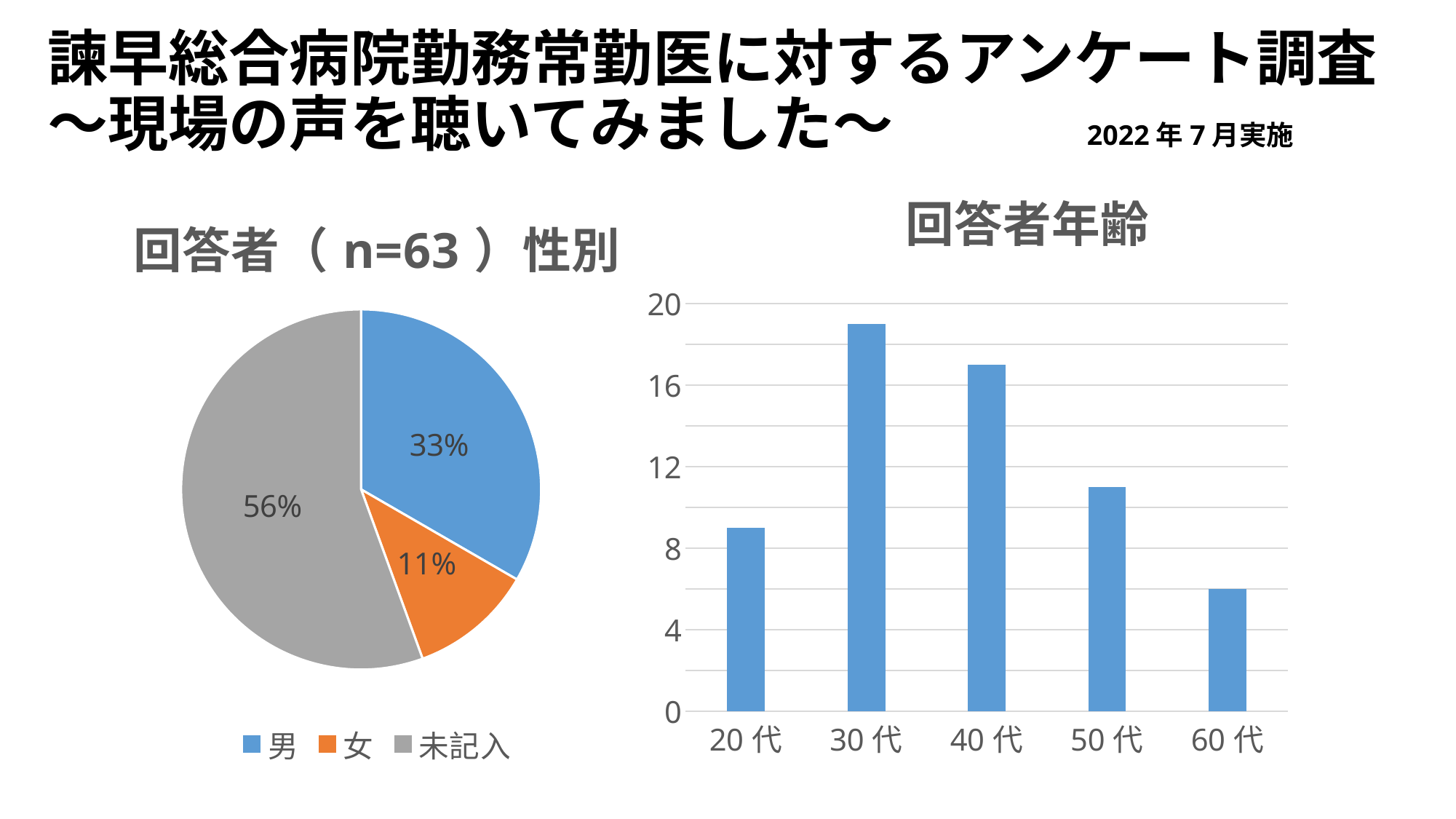
In the pie chart 回答者（n=63）性別, which category has the smallest share? 女 In the pie chart 回答者（n=63）性別, which category has the largest share? 未記入 In the bar chart 回答者年齢, is the value for 60代 greater or less than 8? less In the bar chart 回答者年齢, which age group has the highest bar? 30代 In the pie chart 回答者（n=63）性別, what percentage is shown for 女? 11% In the bar chart 回答者年齢, which age group has the lowest bar? 60代 What kind of chart is 回答者年齢? bar chart In the bar chart 回答者年齢, how many age categories are shown on the x axis? 5 In the pie chart 回答者（n=63）性別, how many categories does the legend list? 3 In the pie chart 回答者（n=63）性別, what percentage is shown for 男? 33% In the pie chart 回答者（n=63）性別, what percentage is shown for 未記入? 56% In the pie chart 回答者（n=63）性別, what is the difference in percentage points between 未記入 and 男? 23